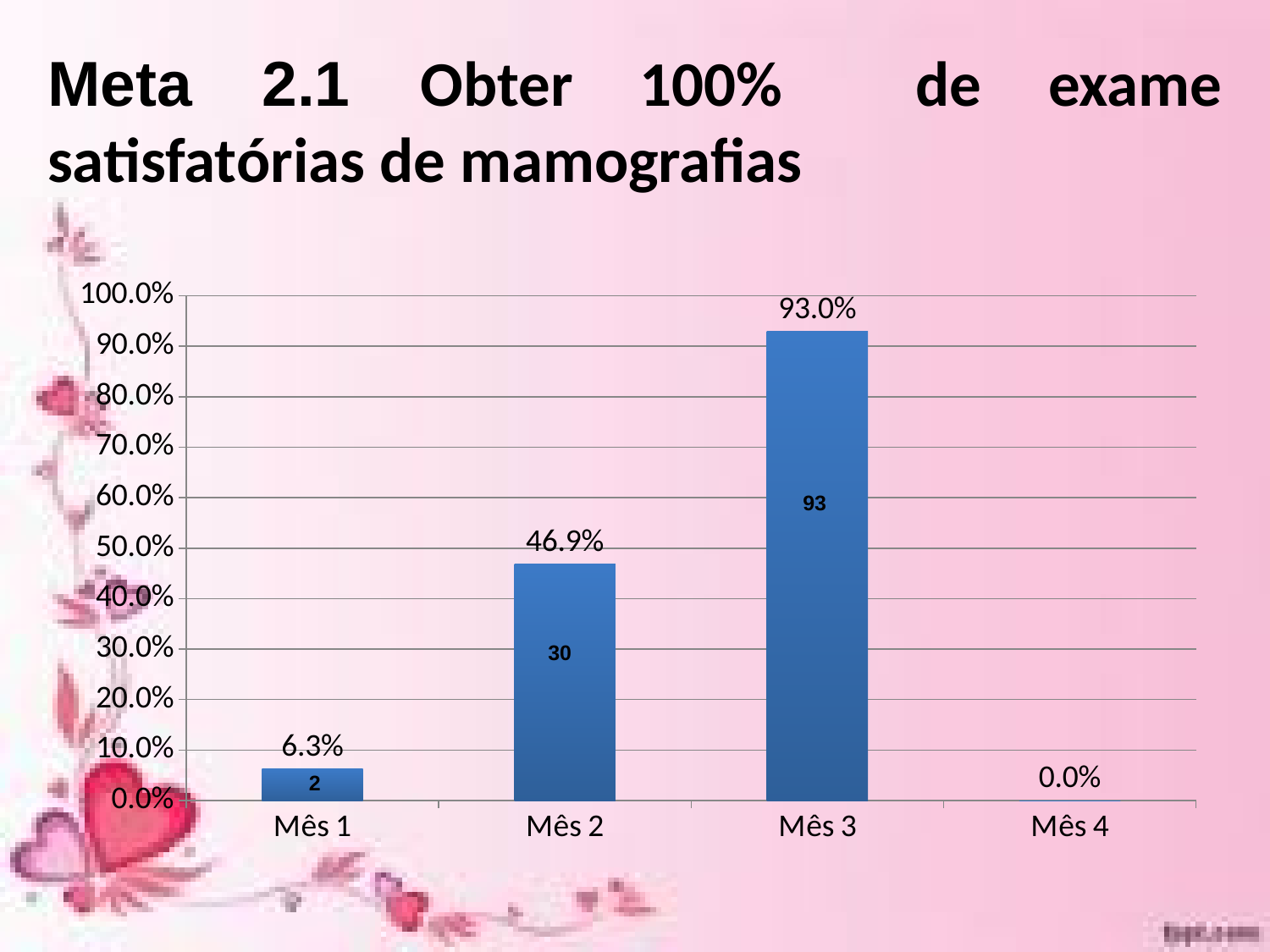
What is the percentage value shown for Mês 1? 6.3% Which month has the lowest percentage? Mês 4 Which is larger, the percentage for Mês 1 or for Mês 2? Mês 2 What is the difference in percentage points between Mês 3 and Mês 2? 46.1 What is the percentage value shown for Mês 3? 93.0% What is the percentage value shown for Mês 4? 0.0% What number is printed inside the bar for Mês 2? 30 How many months (categories) are shown on the x axis? 4 What is the percentage value shown for Mês 2? 46.9% Which month has the highest percentage? Mês 3 What kind of chart is shown on the slide? Bar chart What number is printed inside the bar for Mês 3? 93